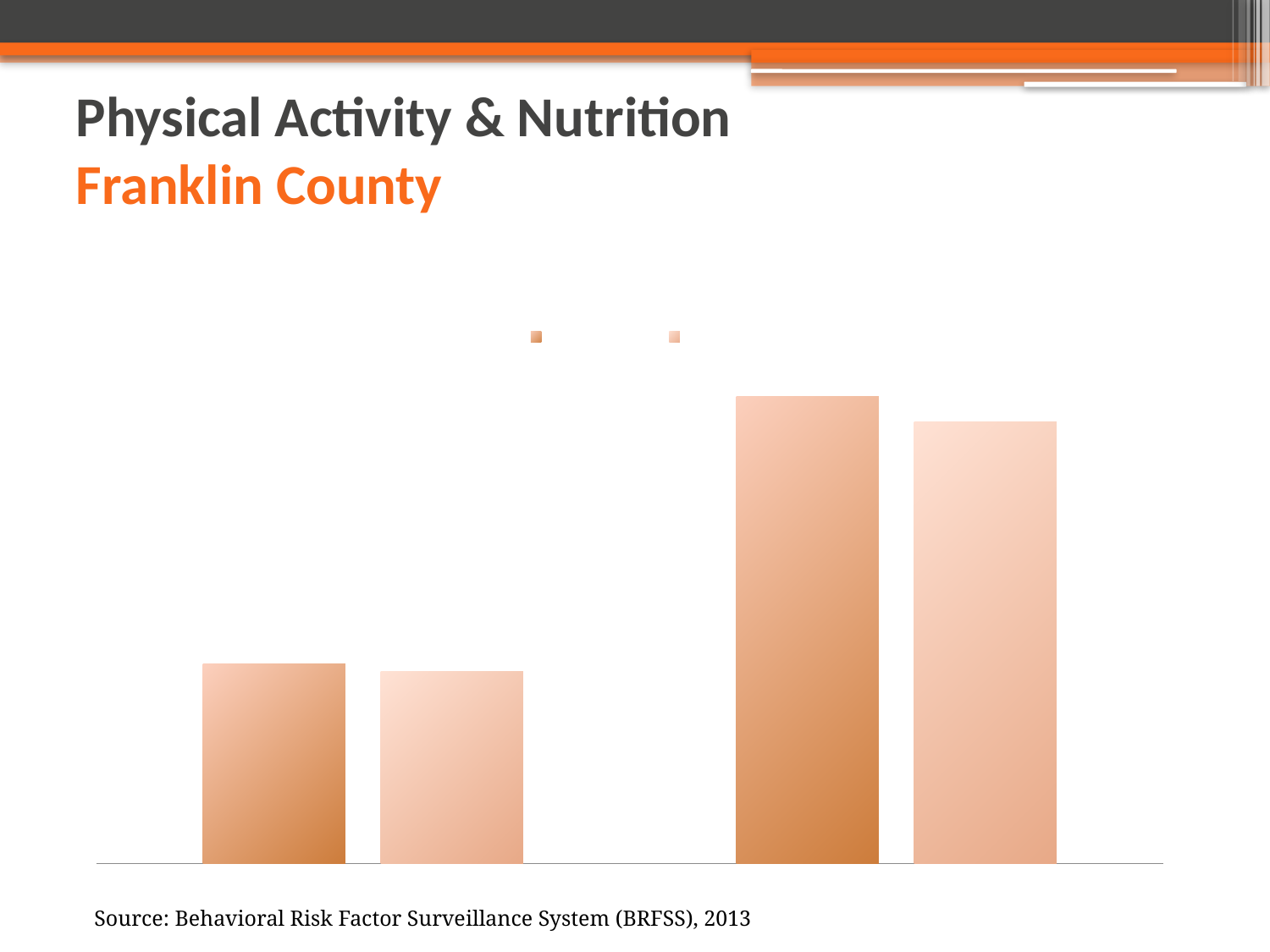
Which bar in the chart is the tallest: the first, second, third or fourth from the left? the third What kind of chart is shown on the slide? bar chart Which group of bars is taller in the chart: the left group or the right group? the right group How many series does the chart's legend list? 2 How many bars are plotted in the chart? 4 Does the chart display any numeric data labels on its bars? No Which is taller in the chart: the leftmost bar or the third bar from the left? the third bar from the left Which bar in the chart is the shortest: the first, second, third or fourth from the left? the second Within the right-hand group of bars, which bar is taller: the darker orange bar or the lighter orange bar? the darker orange bar What source is cited below the chart? Behavioral Risk Factor Surveillance System (BRFSS), 2013 How many groups of bars does the chart show? 2